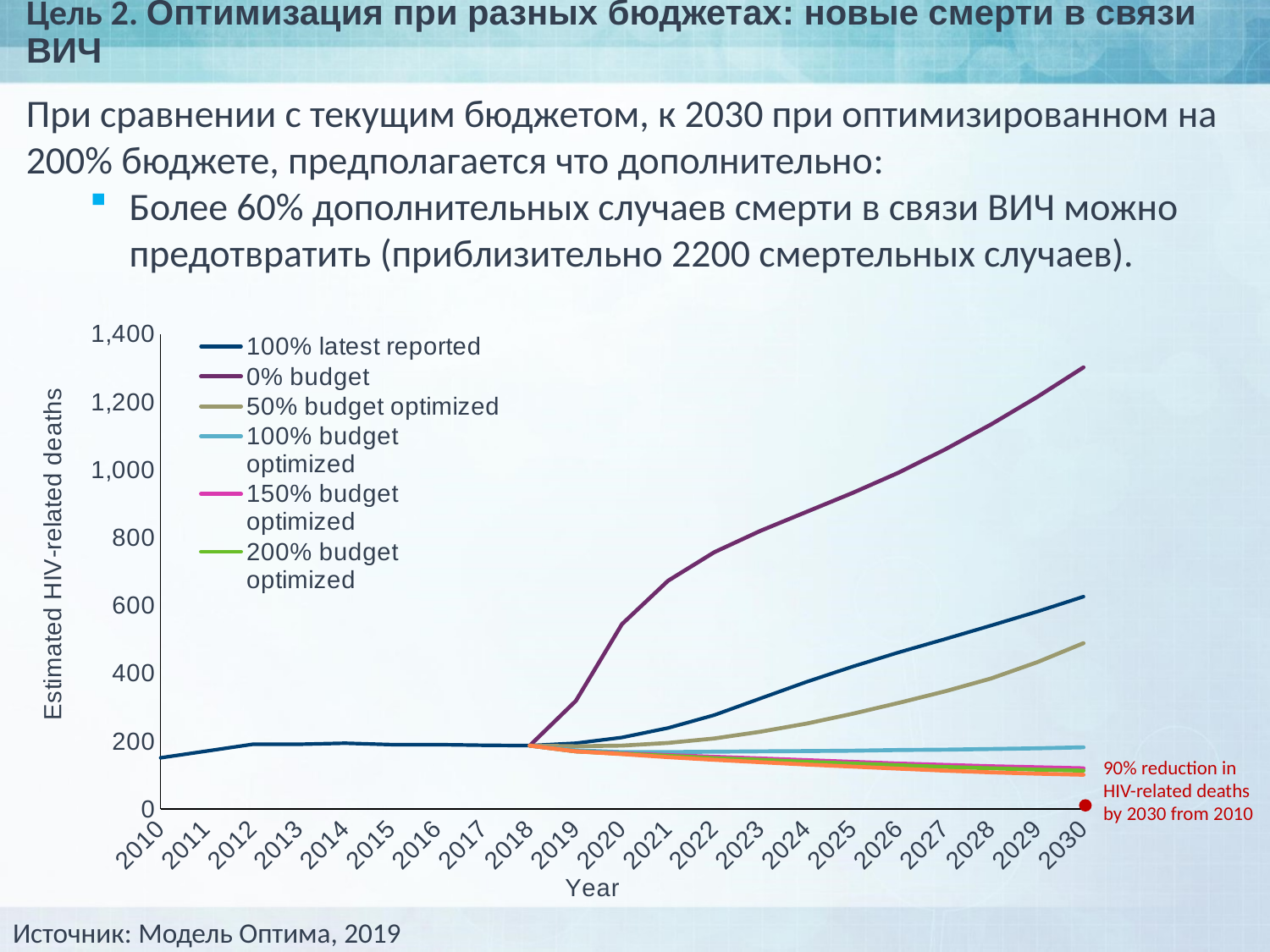
Is the value for the 100% latest reported series in 2030 greater or less than 400? greater Which series has the highest value in 2030? 0% budget Is the value for the 0% budget series in 2030 greater or less than 1,200? greater Is the value for the 50% budget optimized series in 2030 greater or less than 600? less What is the label of the x axis of the chart? Year How many years are labelled along the x axis of the chart? 21 In 2030, which is larger: the 0% budget series or the 100% latest reported series? 0% budget What kind of chart is shown on the slide? line chart Does the 0% budget series rise or fall between 2018 and 2030? rise What is the label of the y axis of the chart? Estimated HIV-related deaths How many series does the chart legend list? 6